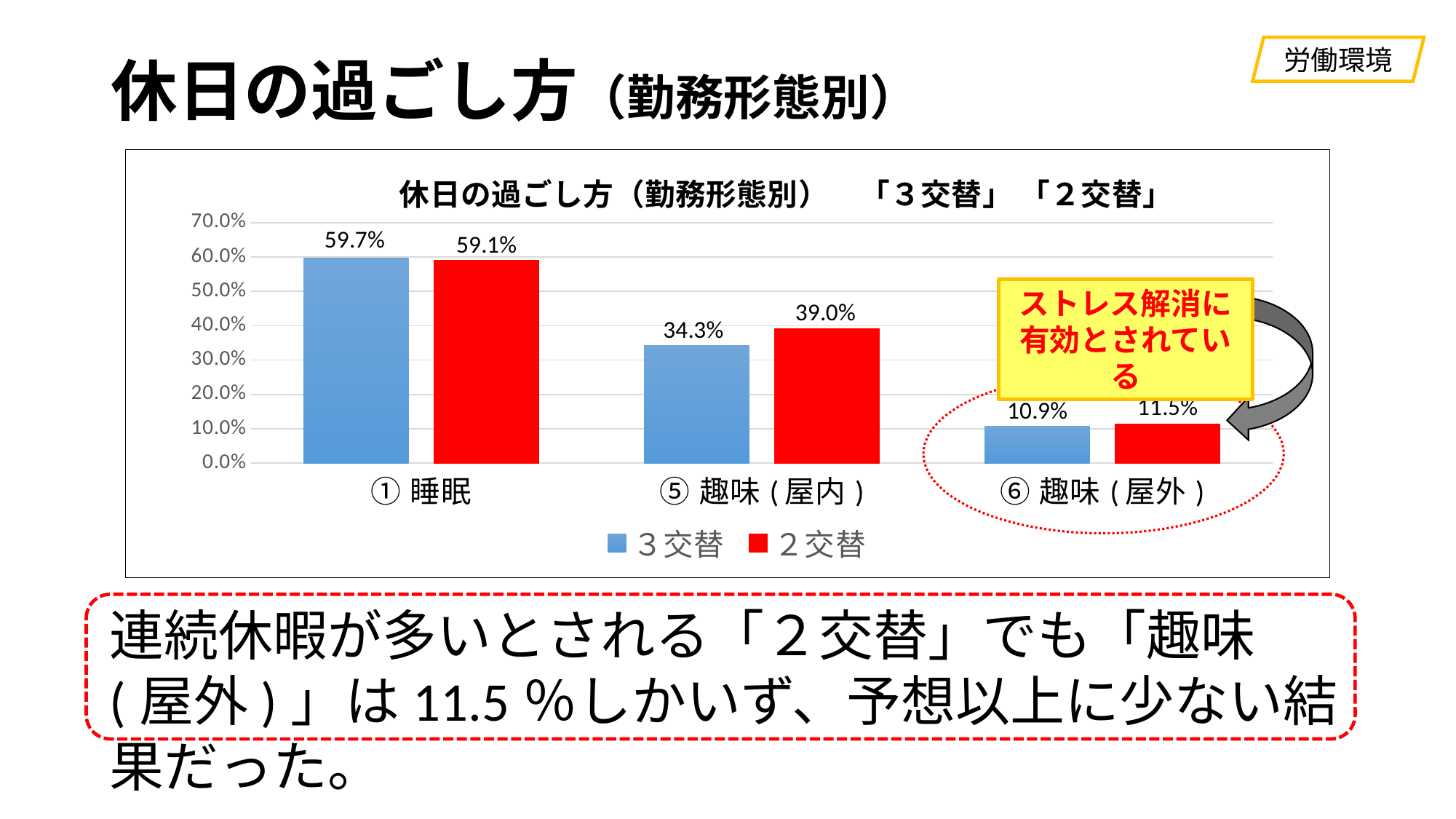
What kind of chart is shown on the slide? Bar chart What is the value for ２交替 in the ⑤ 趣味(屋内) category? 39.0% How many categories are shown on the x axis? 3 How many series does the legend list? 2 What is the value for ３交替 in the ⑥ 趣味(屋外) category? 10.9% In the ⑥ 趣味(屋外) category, which series has the larger value, ３交替 or ２交替? ２交替 What is the value for ３交替 in the ① 睡眠 category? 59.7% Is the value for ３交替 in ⑤ 趣味(屋内) greater or less than 30.0%? greater Which category has the lowest value for ３交替? ⑥ 趣味(屋外) Which colour represents the ２交替 series in the chart? Red What is the difference between ２交替 and ３交替 in the ⑤ 趣味(屋内) category? 4.7% Which category has the highest value for ２交替? ① 睡眠